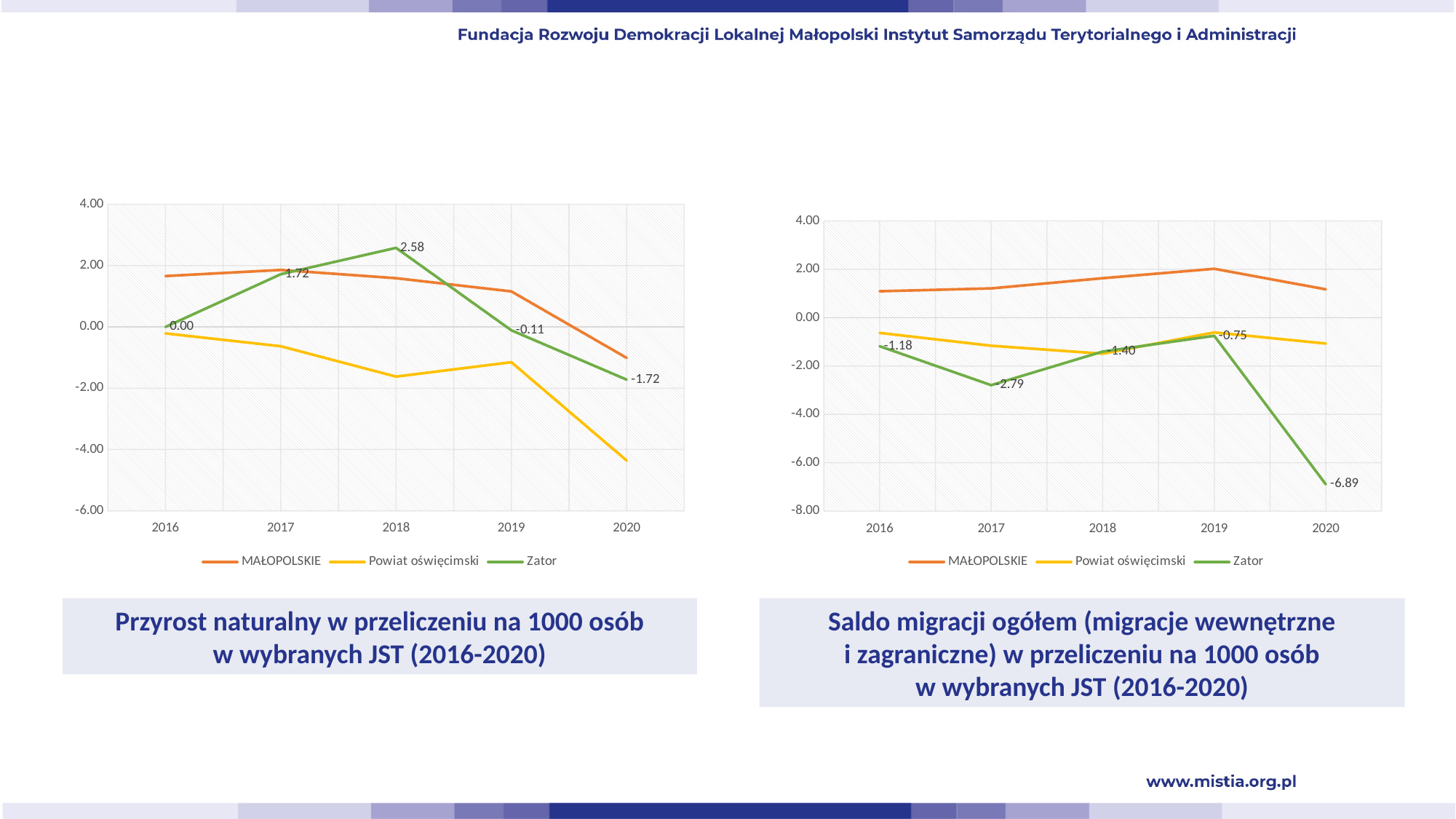
In the left chart (Przyrost naturalny), how many series does the legend list? 3 In the left chart (Przyrost naturalny), what is the value for Zator in 2020? -1.72 In the right chart (Saldo migracji ogółem), which is larger: the Zator value in 2019 or in 2016? 2019 In the right chart (Saldo migracji ogółem), what is the value for Zator in 2020? -6.89 In the left chart (Przyrost naturalny), in which year is the Zator value highest? 2018 In the right chart (Saldo migracji ogółem), how many years are shown on the x axis? 5 In the left chart (Przyrost naturalny), is the value for Powiat oświęcimski in 2020 greater or less than -4.00? less In the right chart (Saldo migracji ogółem), in which year is the Zator value lowest? 2020 In the right chart (Saldo migracji ogółem), what is the value for Zator in 2017? -2.79 In the left chart (Przyrost naturalny), what is the difference between the Zator values in 2018 and 2017? 0.86 What kind of chart is the right chart (Saldo migracji ogółem)? line chart In the left chart (Przyrost naturalny), what is the value for Zator in 2018? 2.58